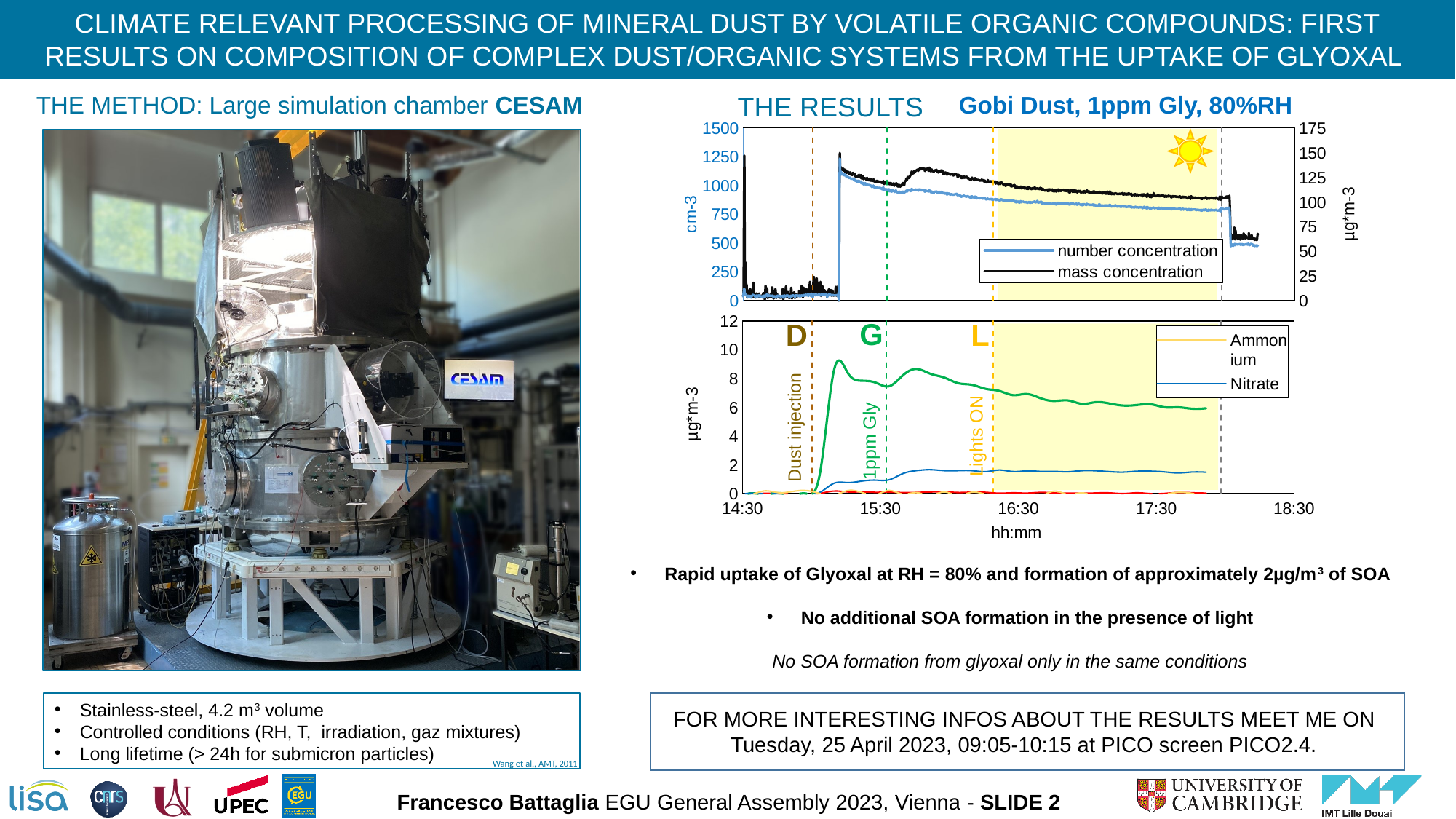
How many series does the legend of the top chart list? 2 In the top chart, is the number concentration at 17:30 greater or less than 500 cm-3? greater In the top chart, what is the maximum value shown on the left y axis (cm-3)? 1500 What is the label of the x axis shared by the two charts? hh:mm In the top chart, does the number concentration rise or fall between 15:30 and 17:30? fall What are the two series named in the legend of the top chart? number concentration, mass concentration In the bottom chart, is the peak of the green line shortly after 15:00 greater or less than 8 µg*m-3? greater What is the title printed above the top chart? Gobi Dust, 1ppm Gly, 80%RH In the top chart, what is the maximum value shown on the right y axis (µg*m-3)? 175 In the bottom chart, is the Nitrate value at 17:30 greater or less than 4 µg*m-3? less In the bottom chart, what is the maximum value shown on the y axis (µg*m-3)? 12 What kind of chart is the top chart on the right side of the slide? line chart